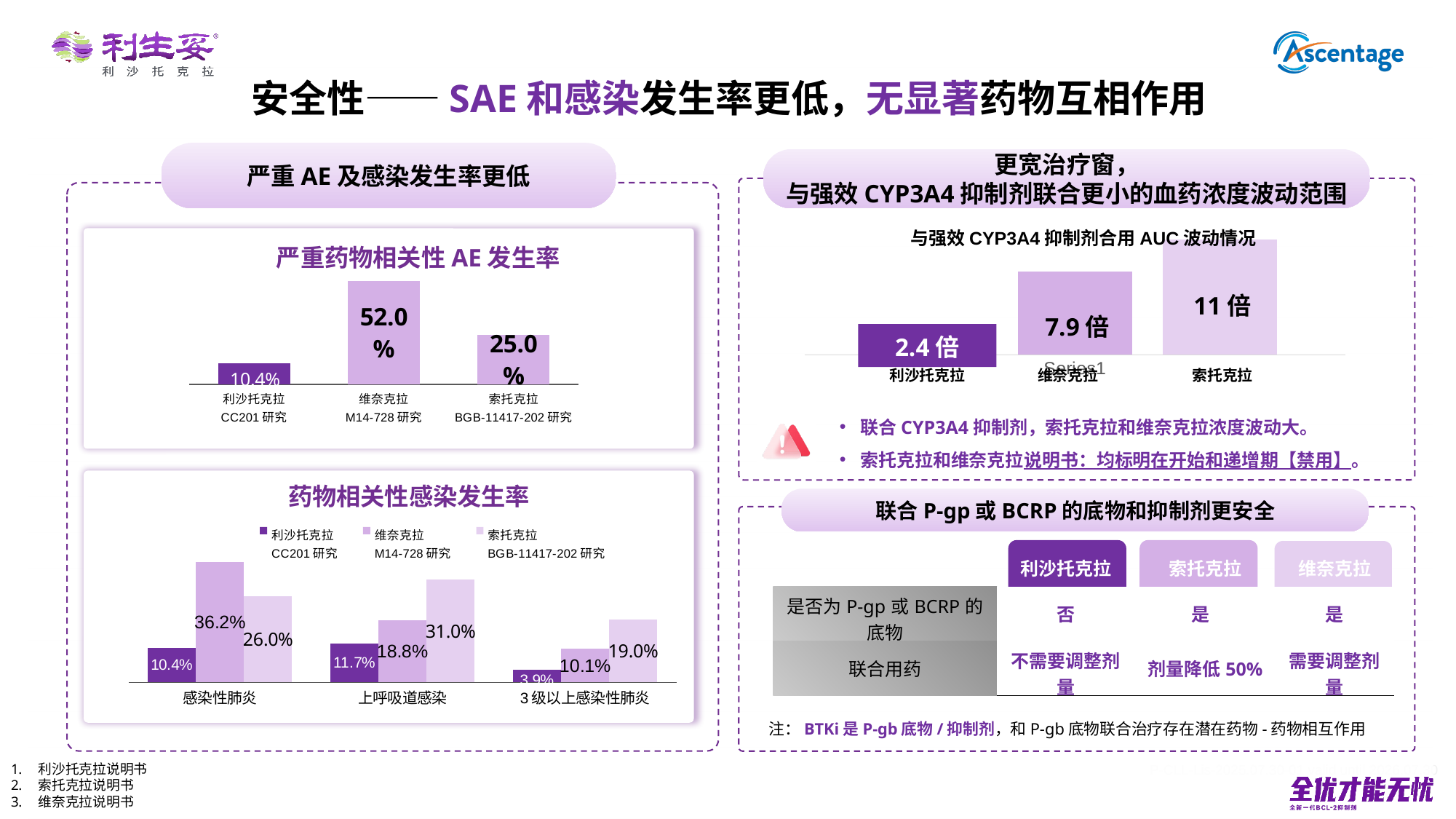
In the 药物相关性感染发生率 chart, how many series does the legend list? 3 In the 药物相关性感染发生率 chart, what is the value for 利沙托克拉 in the 3 级以上感染性肺炎 category? 3.9% In the 与强效 CYP3A4 抑制剂合用 AUC 波动情况 chart, do the values rise or fall from left to right? Rise In the 药物相关性感染发生率 chart, what is the value for 索托克拉 in the 上呼吸道感染 category? 31.0% In the 药物相关性感染发生率 chart, which series has the highest value for 感染性肺炎? 维奈克拉 In the 严重药物相关性 AE 发生率 chart, what is the difference between the rates for 维奈克拉 and 索托克拉? 27.0% What kind of chart is the 严重药物相关性 AE 发生率 chart? Bar chart In the 与强效 CYP3A4 抑制剂合用 AUC 波动情况 chart, which drug has the smallest AUC fluctuation? 利沙托克拉 In the 严重药物相关性 AE 发生率 chart, which drug has the lowest rate? 利沙托克拉 In the 药物相关性感染发生率 chart, how many categories are shown on the x axis? 3 In the 与强效 CYP3A4 抑制剂合用 AUC 波动情况 chart, what is the value for 索托克拉? 11 倍 In the 严重药物相关性 AE 发生率 chart, what is the value for 维奈克拉 (M14-728 研究)? 52.0%